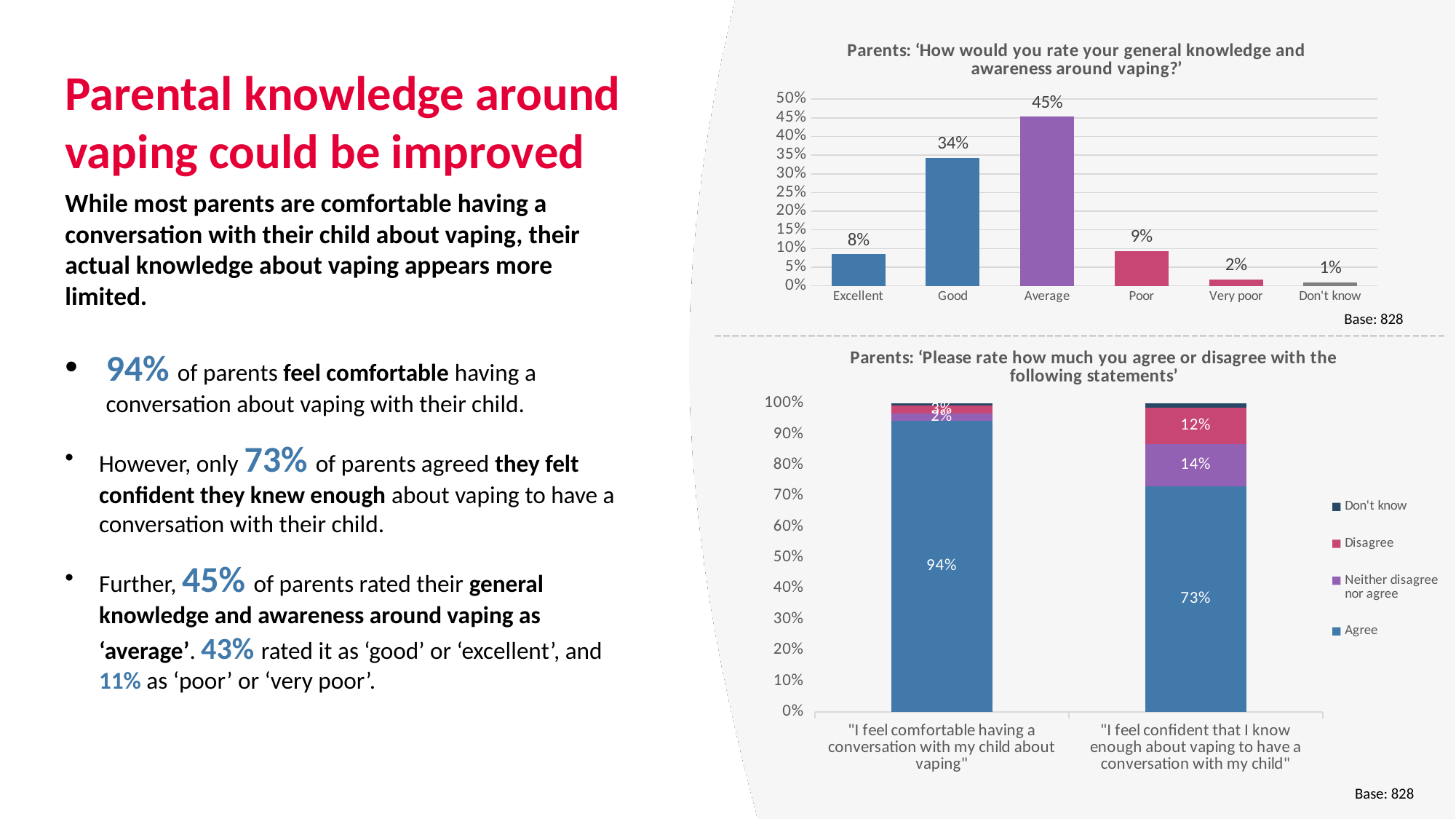
In the bottom chart on agreement with statements, what percentage of parents agreed with 'I feel confident that I know enough about vaping to have a conversation with my child'? 73% In the top chart on general knowledge and awareness around vaping, what is the difference in percentage points between 'Average' and 'Good'? 11 How many series does the legend of the bottom chart on agreement with statements list? 4 In the top chart on general knowledge and awareness around vaping, what percentage of parents rated their knowledge as 'Good'? 34% In the top chart on general knowledge and awareness around vaping, what percentage of parents answered 'Don't know'? 1% In the bottom chart on agreement with statements, what percentage of parents disagreed with 'I feel confident that I know enough about vaping to have a conversation with my child'? 12% In the top chart on general knowledge and awareness around vaping, which is larger: the percentage for 'Poor' or for 'Excellent'? Poor In the top chart on general knowledge and awareness around vaping, which rating category has the lowest percentage? Don't know In the top chart on general knowledge and awareness around vaping, what percentage of parents rated their knowledge as 'Average'? 45% In the top chart on general knowledge and awareness around vaping, which rating category has the highest percentage? Average How many rating categories are shown on the x axis of the top chart on general knowledge and awareness around vaping? 6 What type of chart is the top chart on general knowledge and awareness around vaping? Bar chart